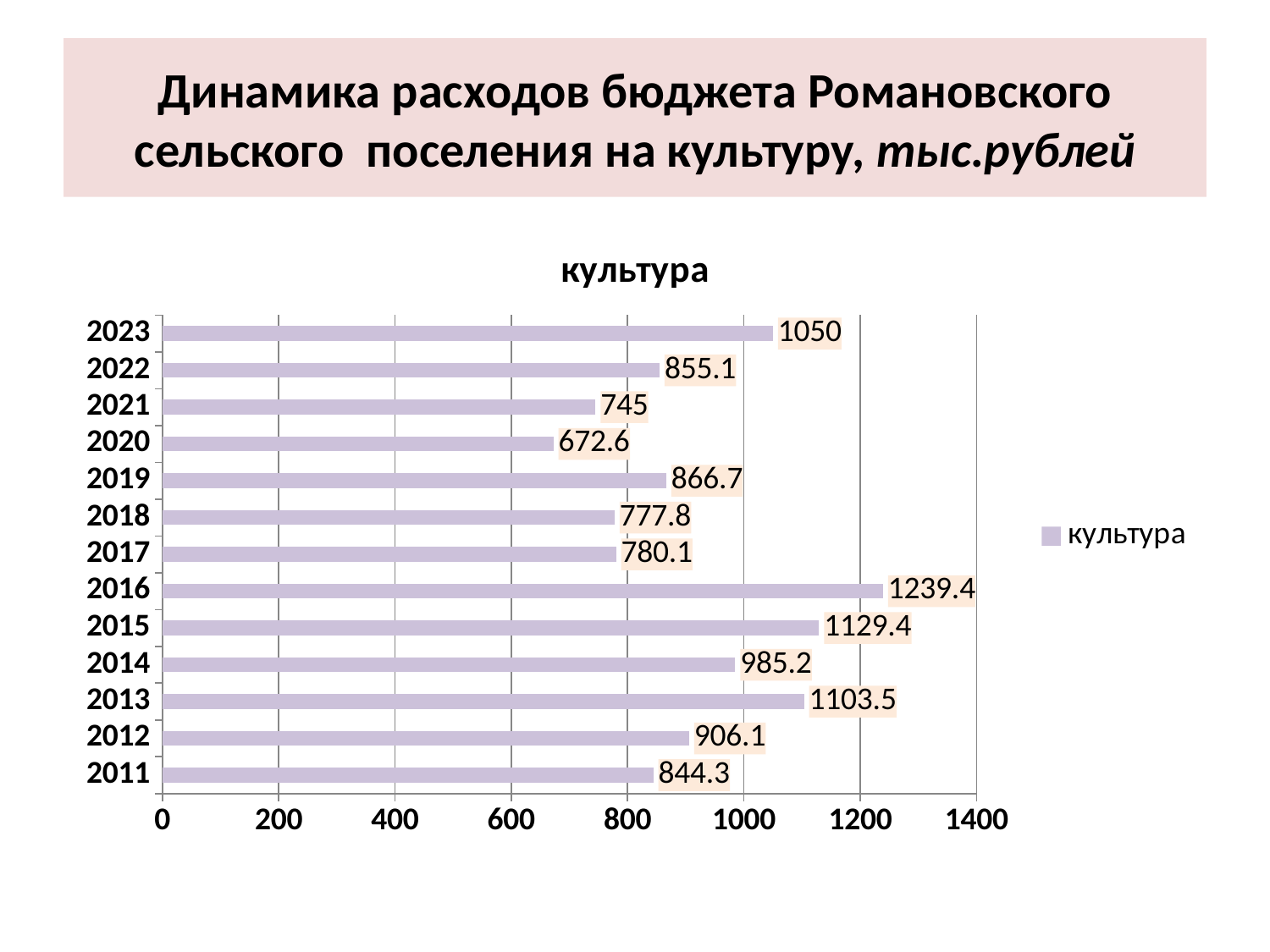
How many years are shown on the chart? 13 Which year has the lowest value? 2020 What is the value for 2023? 1050 What is the value for 2016? 1239.4 What is the value for 2020? 672.6 Is the value for 2014 greater or less than 1000? less What is the difference between the values for 2023 and 2022? 194.9 How many series does the legend list? 1 Which year has the highest value? 2016 What kind of chart is shown? bar chart Which is larger, the value for 2015 or the value for 2013? 2015 What is the title of the chart? культура